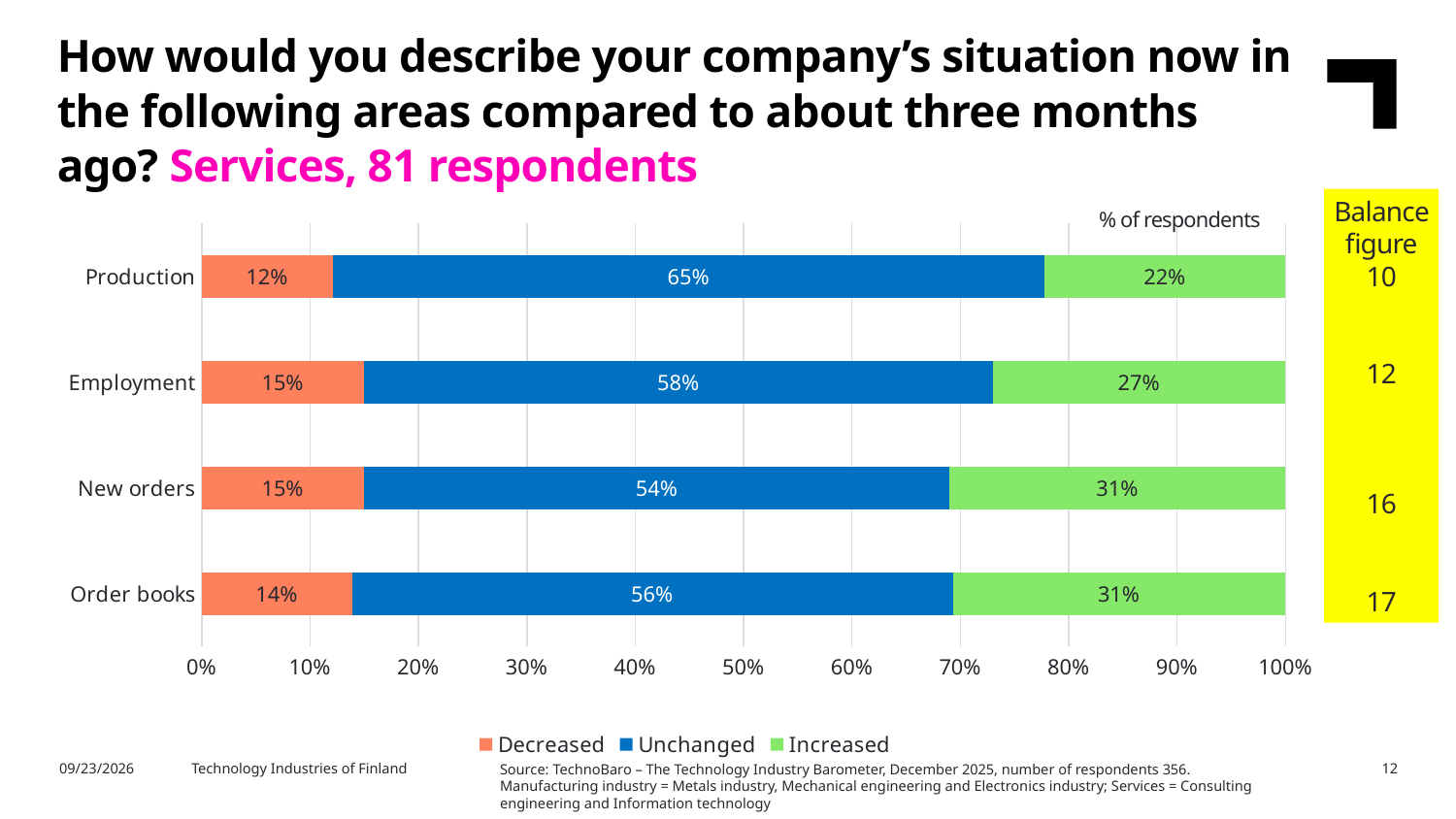
Which colour represents the 'Increased' series in the legend? Green Which category has the highest share of 'Unchanged' responses? Production What kind of chart is shown on the slide? Stacked bar chart Which is larger: the 'Unchanged' share for Employment or the 'Unchanged' share for Order books? Employment What is the balance figure shown for Order books? 17 What percentage of respondents reported that Production was unchanged? 65% Which category has the lowest share of 'Decreased' responses? Production How many series does the legend list? 3 How many categories are shown on the y axis of the chart? 4 What percentage of respondents reported that New orders increased? 31% What percentage of respondents reported that Employment decreased? 15% What is the difference between the 'Increased' share for Employment and the 'Increased' share for Production? 5%